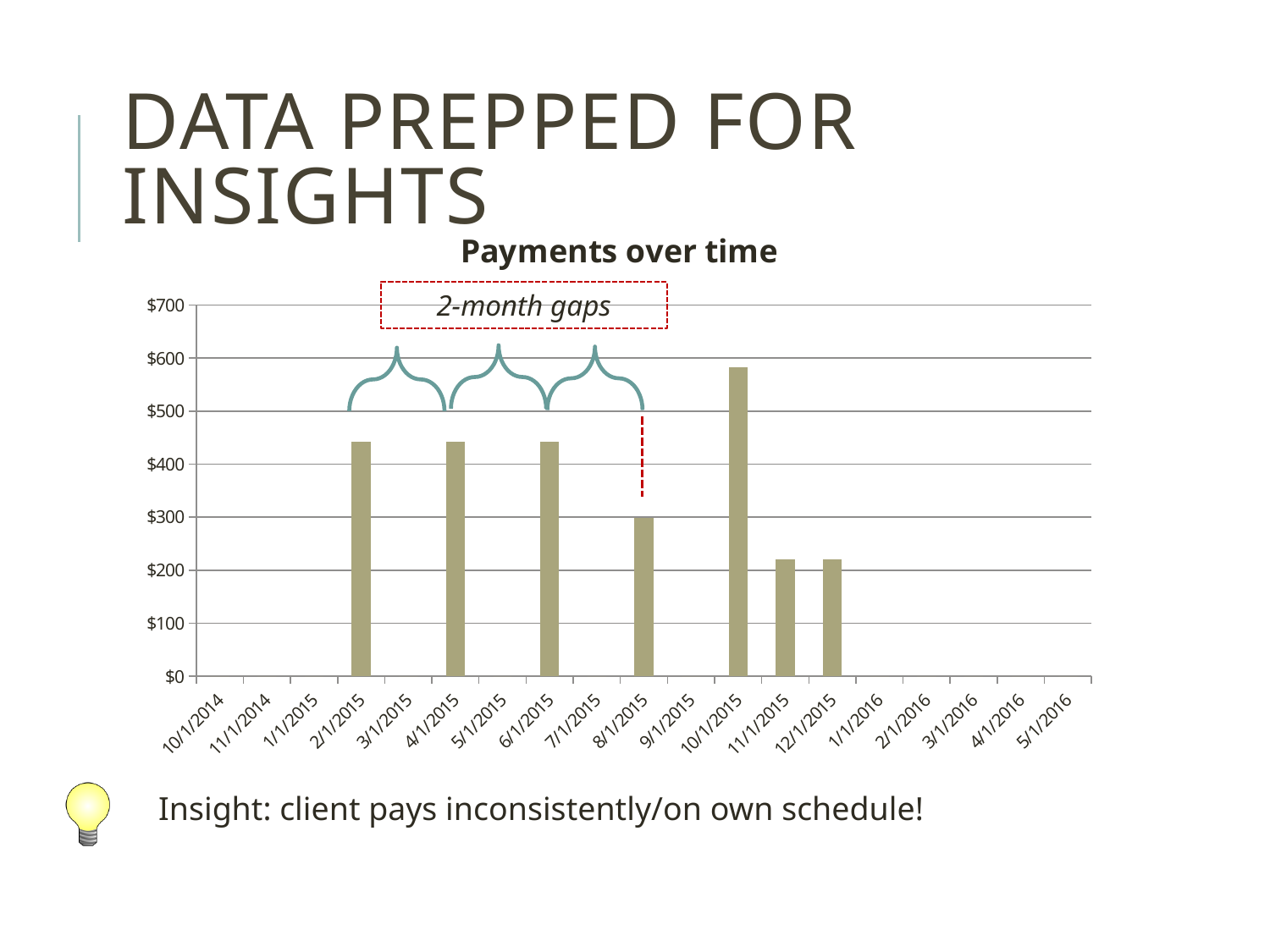
Is the payment for 10/1/2015 greater or less than $500? greater Is the payment for 6/1/2015 greater or less than $500? less Which is larger, the payment for 10/1/2015 or the payment for 11/1/2015? 10/1/2015 What does the annotation above the first three bars say? 2-month gaps Which date has the highest payment bar? 10/1/2015 What is the title of the chart? Payments over time How many bars (payments) are plotted in the chart? 7 Is the payment for 8/1/2015 greater or less than $400? less What kind of chart is shown on the slide? bar chart Which is larger, the payment for 2/1/2015 or the payment for 8/1/2015? 2/1/2015